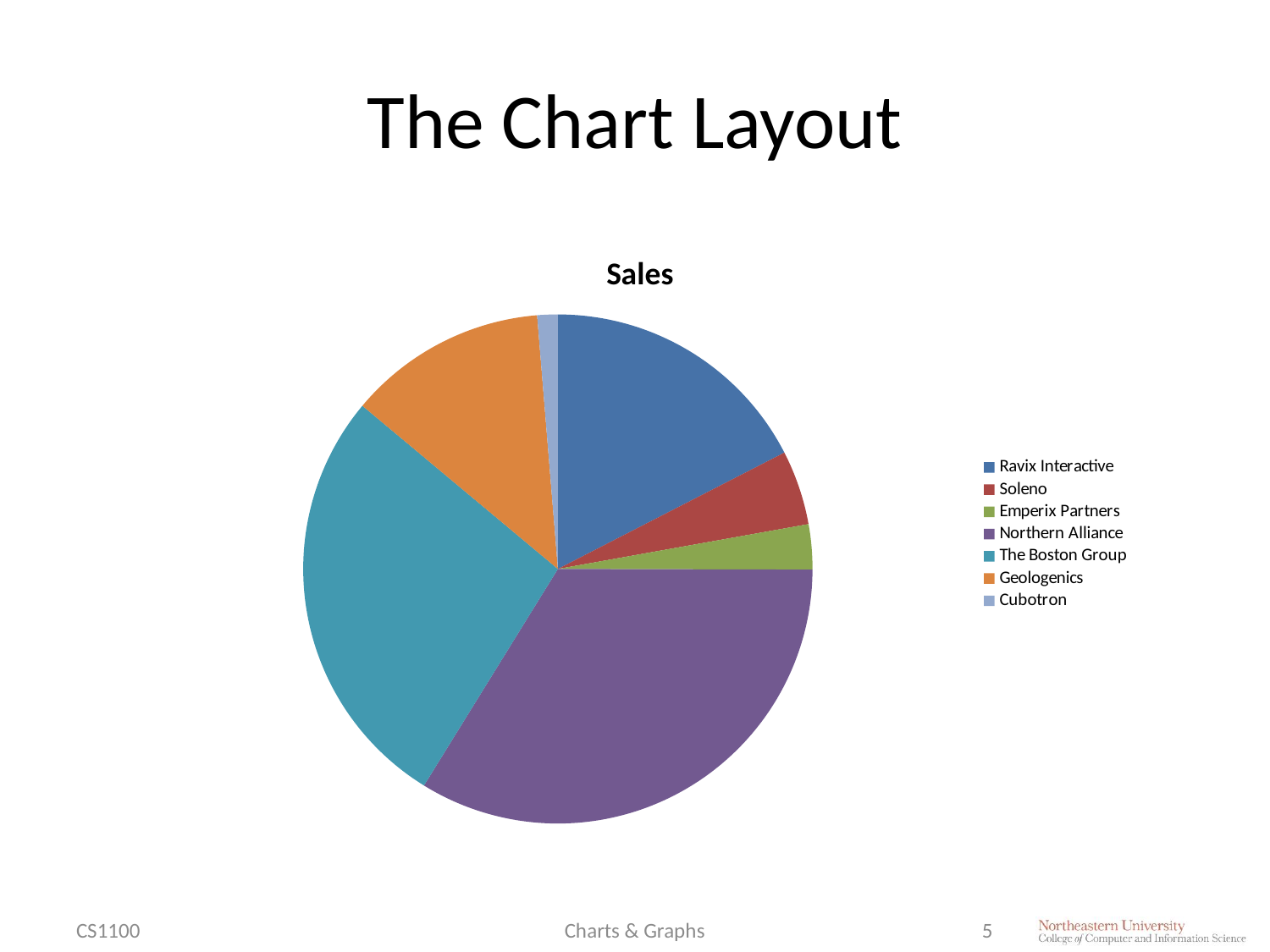
Which slice is larger, Ravix Interactive or Geologenics? Ravix Interactive What kind of chart is shown on the slide? pie chart How many categories (slices) does the pie chart have? 7 Which slice is larger, Northern Alliance or The Boston Group? Northern Alliance Which slice is larger, Geologenics or Soleno? Geologenics Which category is shown in purple in the pie chart? Northern Alliance Which category has the smallest slice of the pie? Cubotron What is the title of the chart? Sales Which category has the largest slice of the pie? Northern Alliance